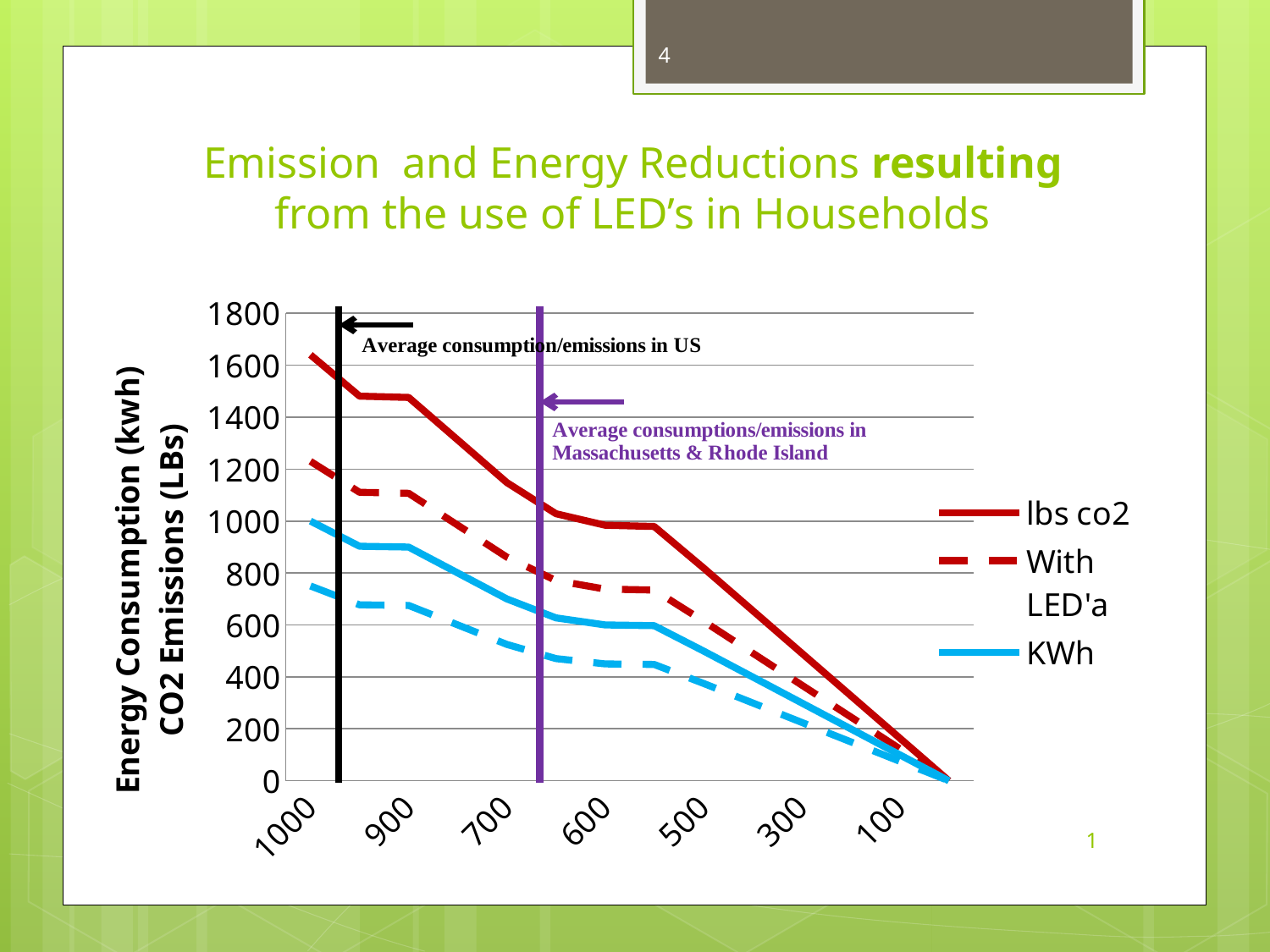
Which series has the highest values across the chart? lbs co2 Is the value for With LED'a at the 1000 category greater or less than 1000? greater Do the values of the lbs co2 series rise or fall moving from left to right along the x axis? fall Is the value for lbs co2 at the 1000 category greater or less than 1400? greater Which series is drawn with a dashed line? With LED'a What does the black vertical line on the chart represent, according to its label? Average consumption/emissions in US What kind of chart is shown on the slide? line chart Is the value for KWh at the 500 category greater or less than 400? greater How many series does the legend list? 3 At the 1000 category, which is larger: the lbs co2 value or the KWh value? lbs co2